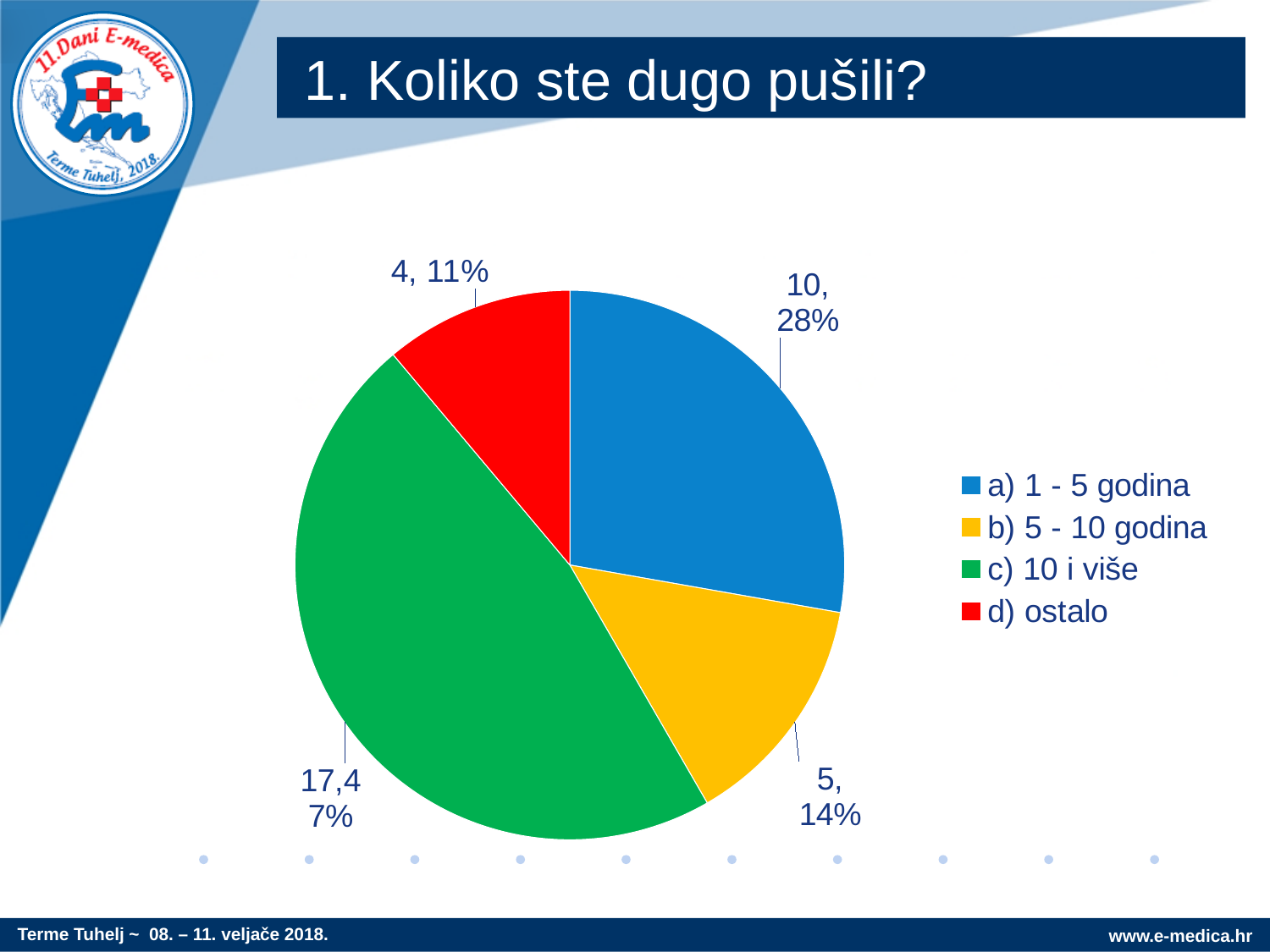
What is the value for "d) ostalo"? 4 What is the title of the slide containing the pie chart? 1. Koliko ste dugo pušili? What share of the pie does "d) ostalo" take? 11% Which category has the largest slice of the pie? c) 10 i više What kind of chart is shown on the slide? pie chart What share of the pie does "b) 5 - 10 godina" take? 14% What share of the pie does "a) 1 - 5 godina" take? 28% What is the value for "b) 5 - 10 godina"? 5 Which category has the smallest slice of the pie? d) ostalo What is the value for "a) 1 - 5 godina"? 10 What is the difference between the values for "a) 1 - 5 godina" and "b) 5 - 10 godina"? 5 How many categories does the pie chart have? 4